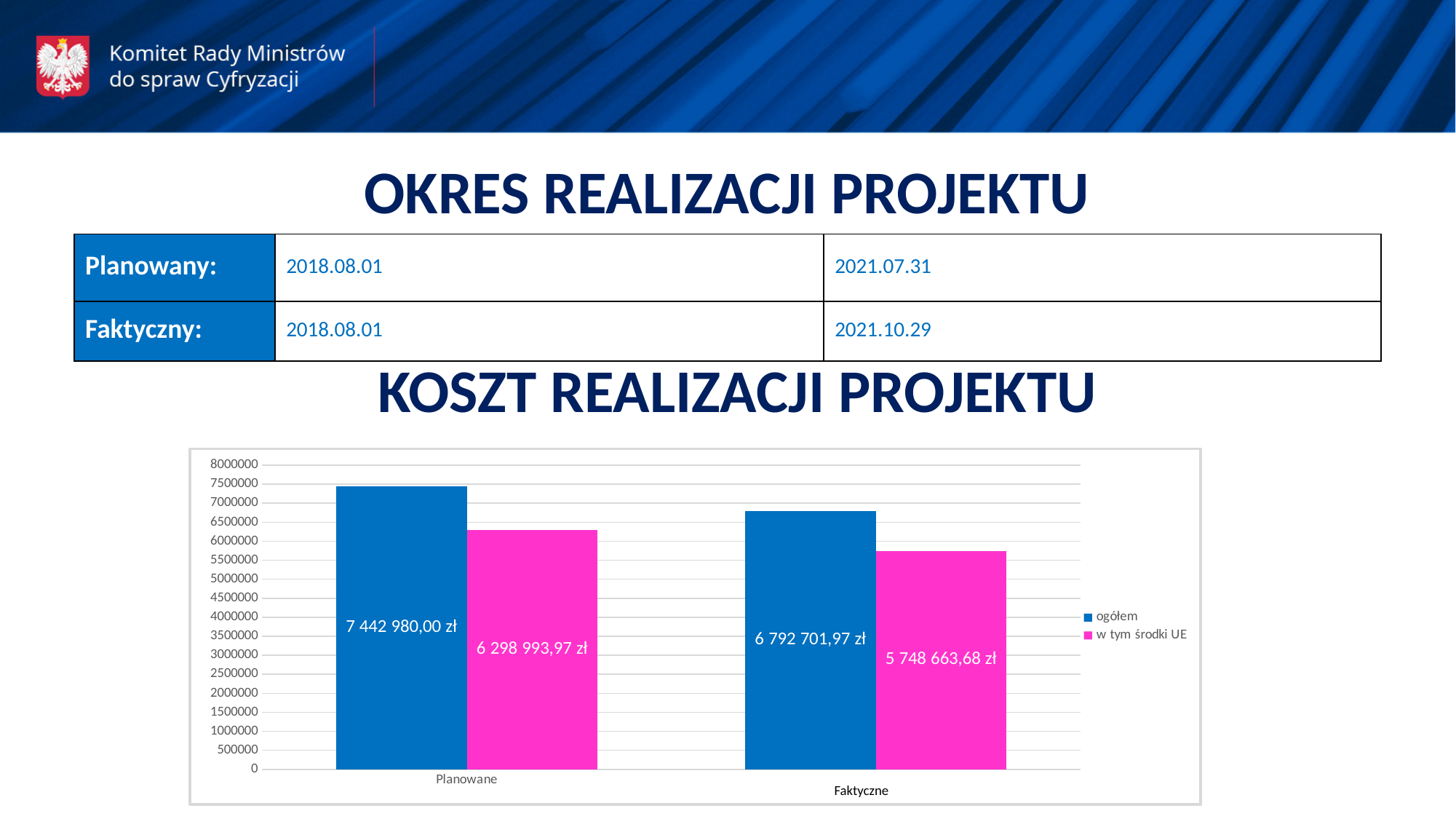
How many series does the chart legend list? 2 What is the value of the "w tym środki UE" bar for Planowane? 6 298 993,97 zł How many categories are shown on the x axis of the chart? 2 What is the difference between the "ogółem" and "w tym środki UE" values for Planowane? 1 143 986,03 zł What is the value of the "w tym środki UE" bar for Faktyczne? 5 748 663,68 zł What type of chart is shown under "KOSZT REALIZACJI PROJEKTU"? Bar chart What is the value of the "ogółem" bar for Planowane? 7 442 980,00 zł What is the difference between the "ogółem" values for Planowane and Faktyczne? 650 278,03 zł What is the value of the "ogółem" bar for Faktyczne? 6 792 701,97 zł Which bar in the chart has the highest value? ogółem for Planowane Which is larger: the "w tym środki UE" value for Planowane or for Faktyczne? Planowane Which bar in the chart has the lowest value? w tym środki UE for Faktyczne